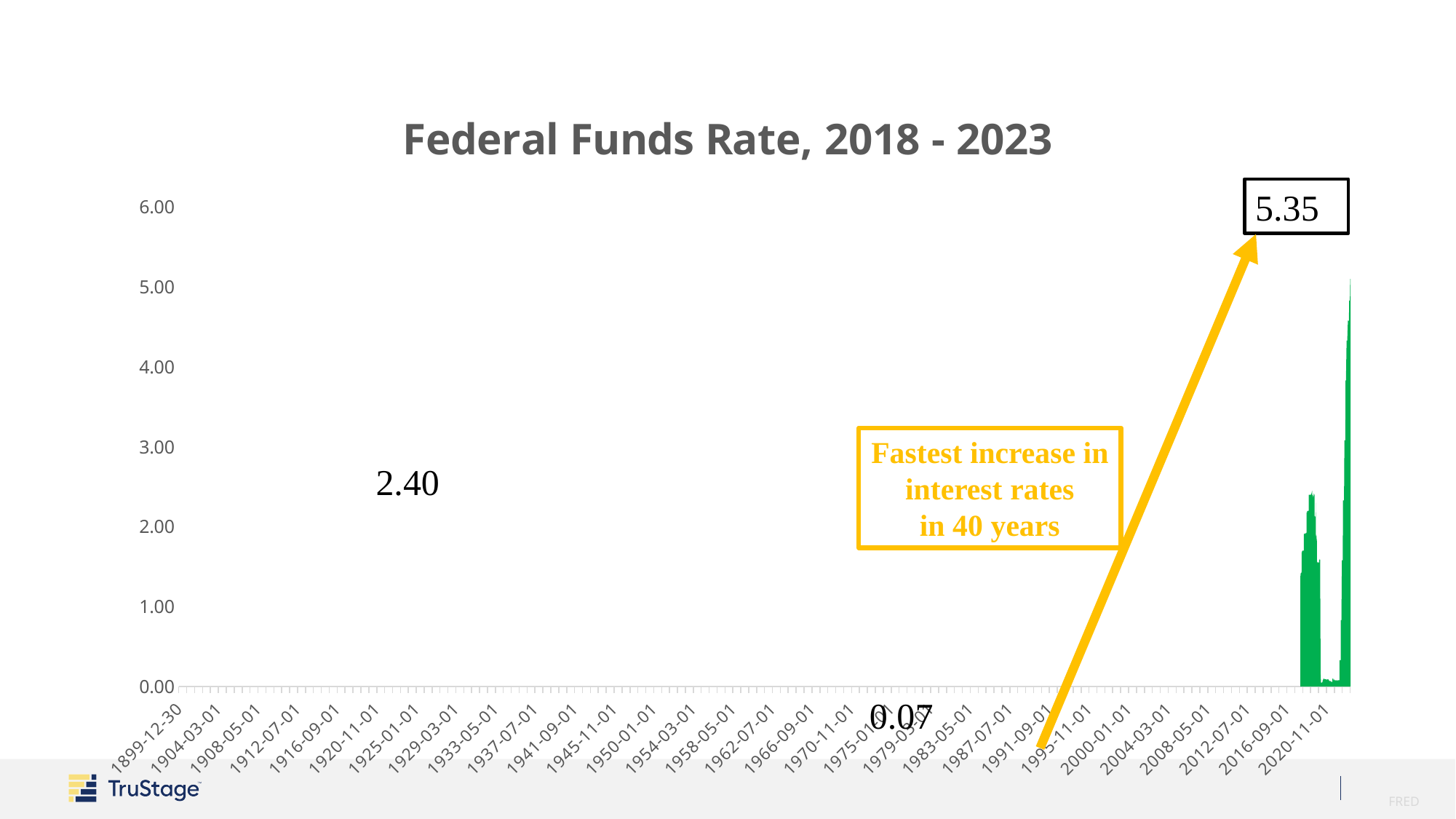
What is the title of the chart? Federal Funds Rate, 2018 - 2023 What does the yellow annotation box on the chart say? Fastest increase in interest rates in 40 years How many data values are labelled on the chart? 3 Is the final peak of the Federal Funds Rate greater or less than 5.00? greater Is the earlier peak of the Federal Funds Rate greater or less than 3.00? less What is the highest value labelled on the chart? 5.35 Does the Federal Funds Rate rise or fall from the 0.07 low to the end of the series? rise Which labelled value is larger, 2.40 or 5.35? 5.35 What is the difference between the labelled values 5.35 and 2.40? 2.95 What is the difference between the labelled peak value 5.35 and the labelled low value 0.07? 5.28 What is the lowest value labelled on the chart? 0.07 What value is labelled for the earlier, smaller peak in the Federal Funds Rate? 2.40